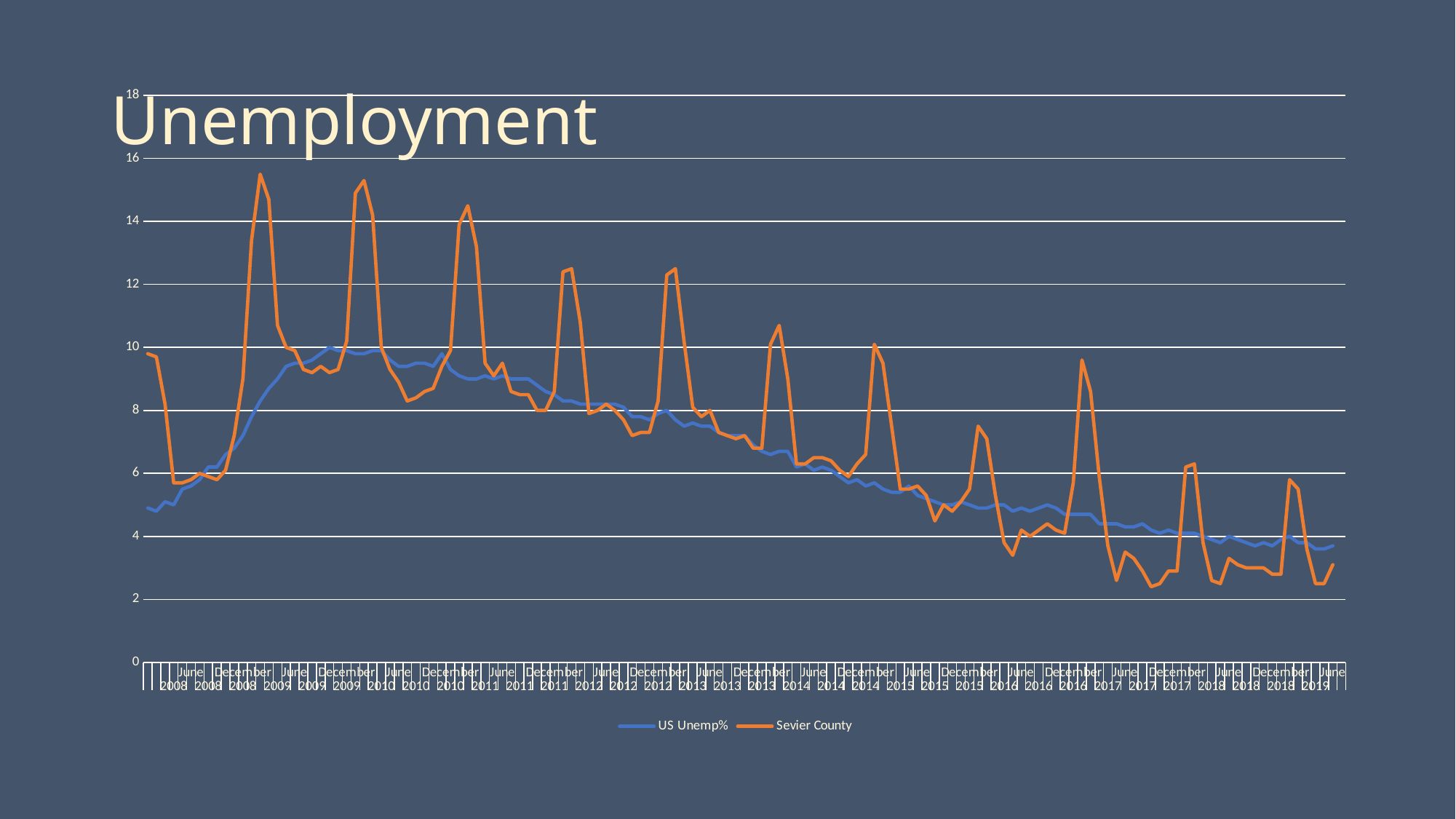
Which series reaches the higher peak value, US Unemp% or Sevier County? Sevier County How many series does the legend list? 2 Is the highest value reached by the Sevier County series greater or less than 14? greater Is the US Unemp% value at the last point (June 2019) greater or less than 4? less Is the highest value reached by the US Unemp% series greater or less than 12? less What kind of chart is shown on the slide? line chart What is the title of the chart? Unemployment Do the Sevier County peaks generally rise or fall from 2009 to 2019? fall From 2010 to 2019, does the US Unemp% series generally rise or fall? fall What are the two series named in the legend? US Unemp% and Sevier County